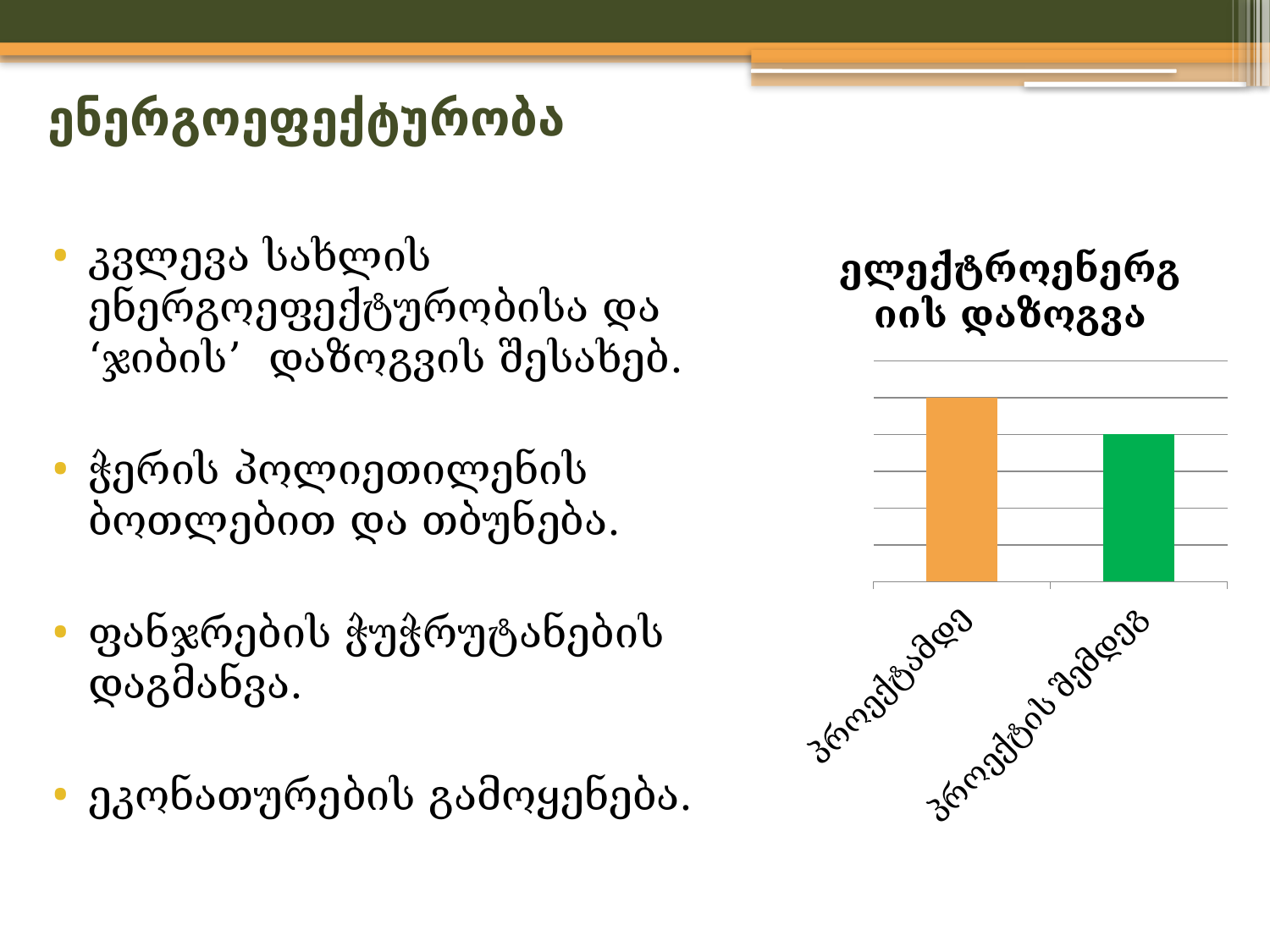
Which is larger, the value for პროექტამდე or the value for პროექტის შემდეგ? პროექტამდე How many categories are plotted in the chart? 2 Do the values rise or fall from left to right along the x axis? fall What colour is the bar for პროექტის შემდეგ? green Which category has the highest bar in the chart? პროექტამდე Which category has the lowest bar in the chart? პროექტის შემდეგ What is the title of the chart? ელექტროენერგიის დაზოგვა What kind of chart is shown on the slide? bar chart